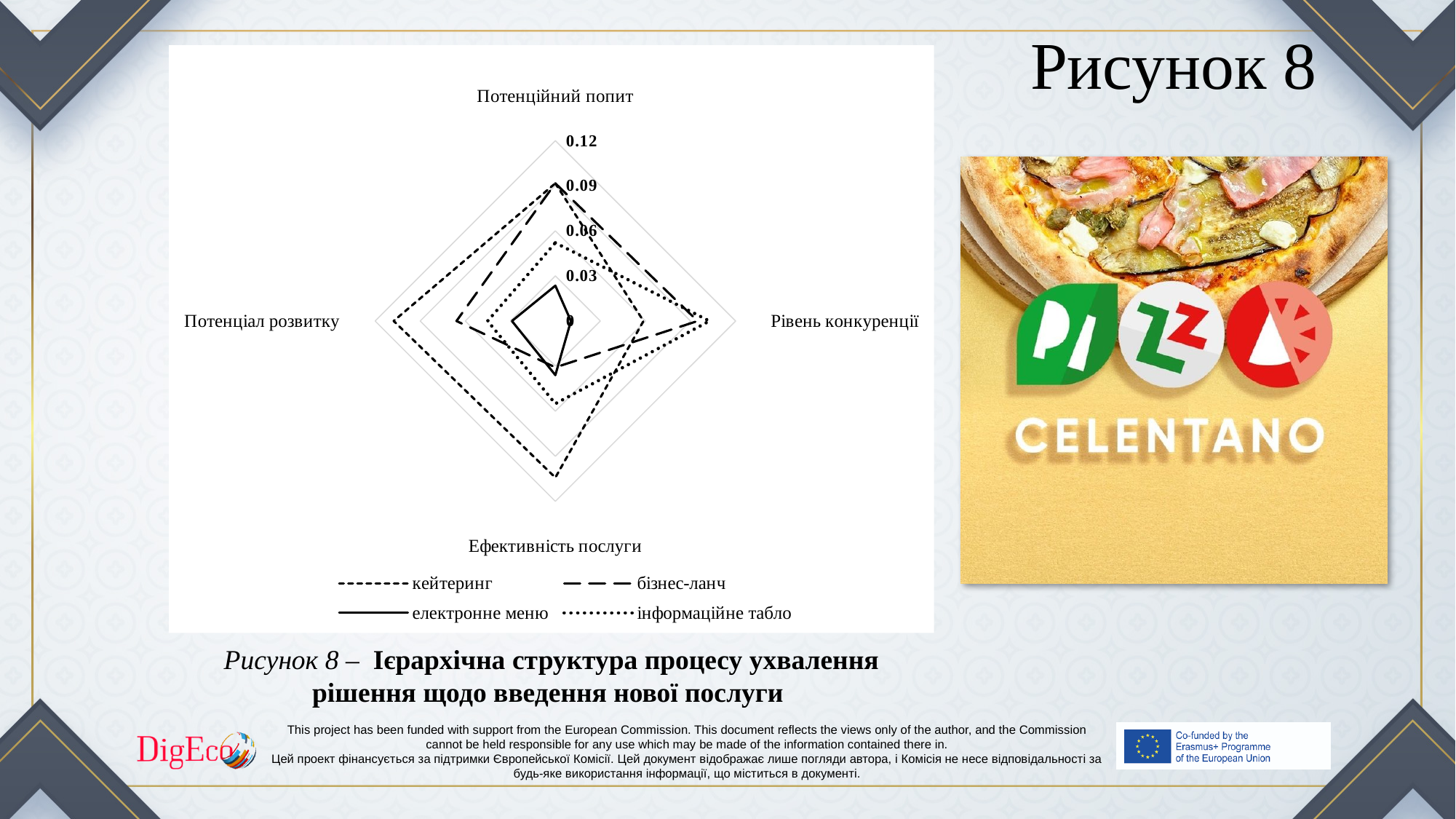
How many series does the legend of the chart list? 4 On the Потенціал розвитку axis, which series has the highest value? кейтеринг How many axes (criteria) does the radar chart have? 4 Is the value for інформаційне табло on the Рівень конкуренції axis greater or less than 0.06? greater Is the value for електронне меню on the Потенційний попит axis greater or less than 0.06? less On the Ефективність послуги axis, which is larger: кейтеринг or бізнес-ланч? кейтеринг Is the value for бізнес-ланч on the Ефективність послуги axis greater or less than 0.06? less Which series is drawn with a solid line in the chart? електронне меню On the Рівень конкуренції axis, which series has the lowest value? електронне меню What kind of chart is shown on the slide? radar chart